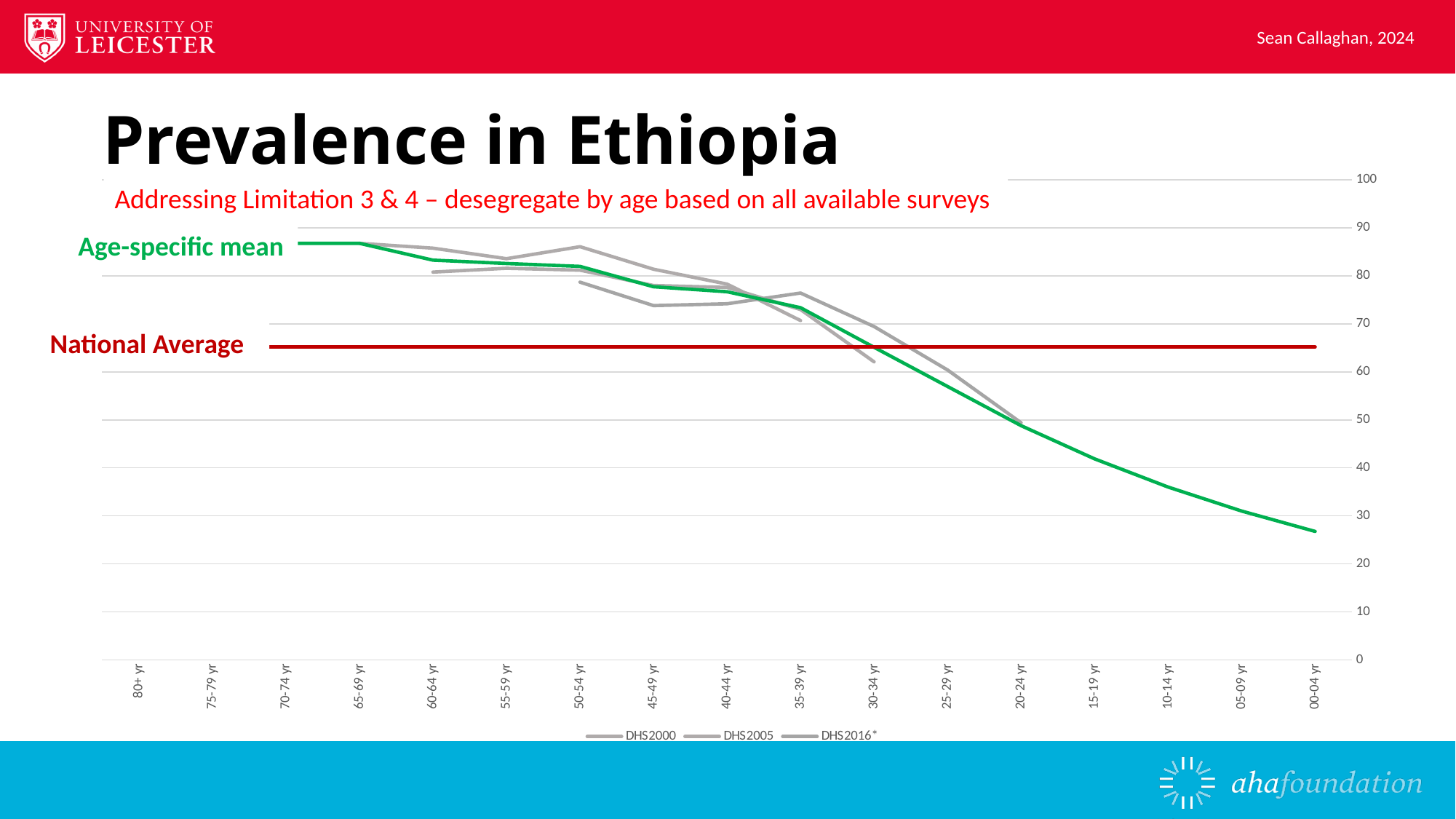
How many age-group categories are shown on the x axis? 17 Which age group has the lowest Age-specific mean value? 00-04 yr Does the Age-specific mean line rise or fall as you move from 80+ yr to 00-04 yr along the x axis? fall What kind of chart is shown on the slide? line chart Is the National Average line greater or less than 70? less Is the National Average line greater or less than 60? greater Is the Age-specific mean value for 00-04 yr greater or less than 30? less Which is larger, the Age-specific mean for 65-69 yr or for 00-04 yr? 65-69 yr What colour is the Age-specific mean line? green How many series does the legend at the bottom of the chart list? 3